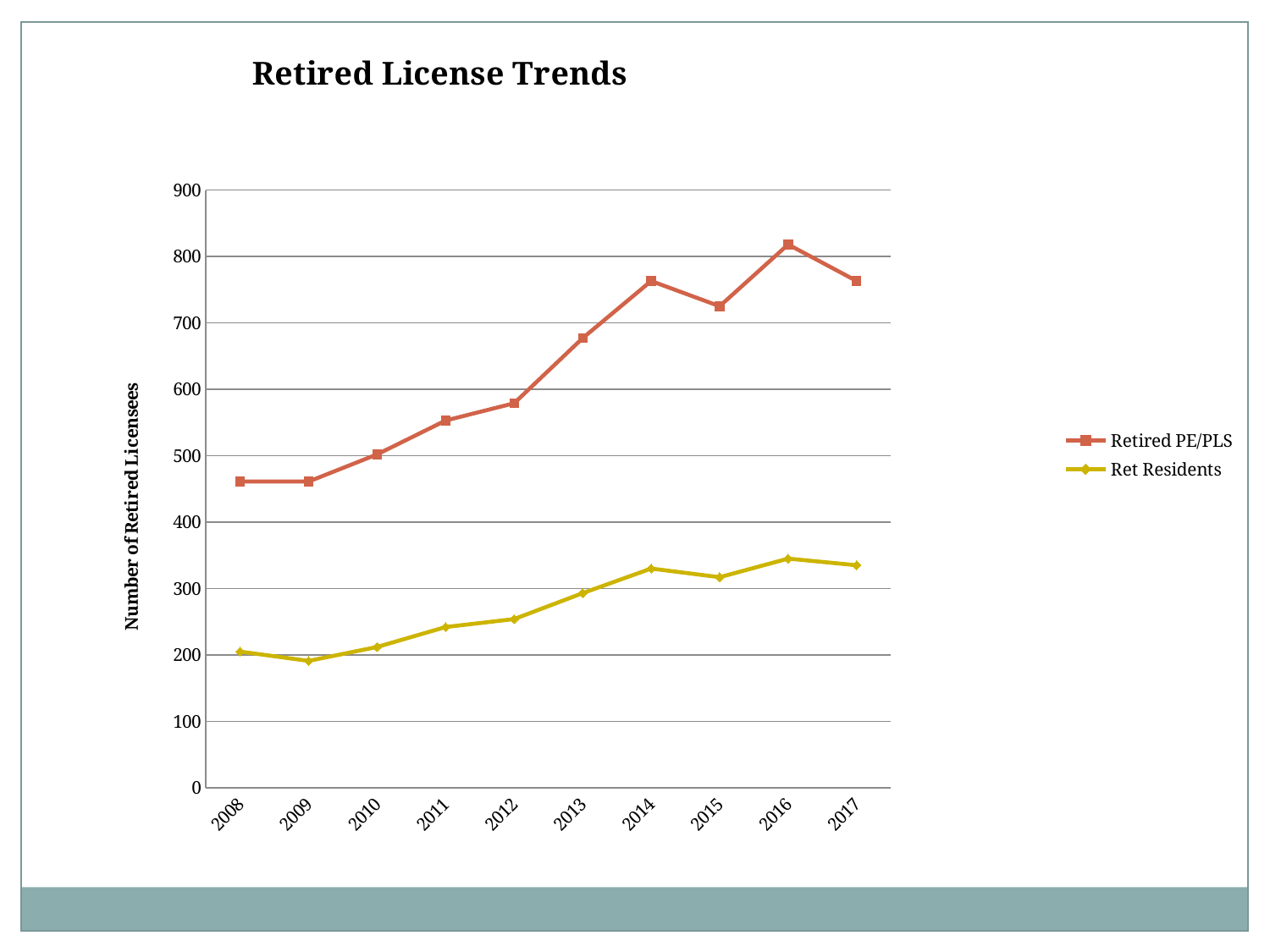
Is the Retired PE/PLS value for 2013 greater or less than 700? less What kind of chart is shown on the slide? line chart How many years are plotted along the x axis? 10 Is the Ret Residents value for 2009 greater or less than 200? less Is the Ret Residents value for 2014 greater or less than 300? greater What is the title of the chart? Retired License Trends How many series does the legend list? 2 In which year does the Retired PE/PLS series reach its highest value? 2016 Which series has the larger value in 2012, Retired PE/PLS or Ret Residents? Retired PE/PLS In which year does the Ret Residents series reach its lowest value? 2009 Overall, do the Retired PE/PLS values rise or fall from 2008 to 2017? rise